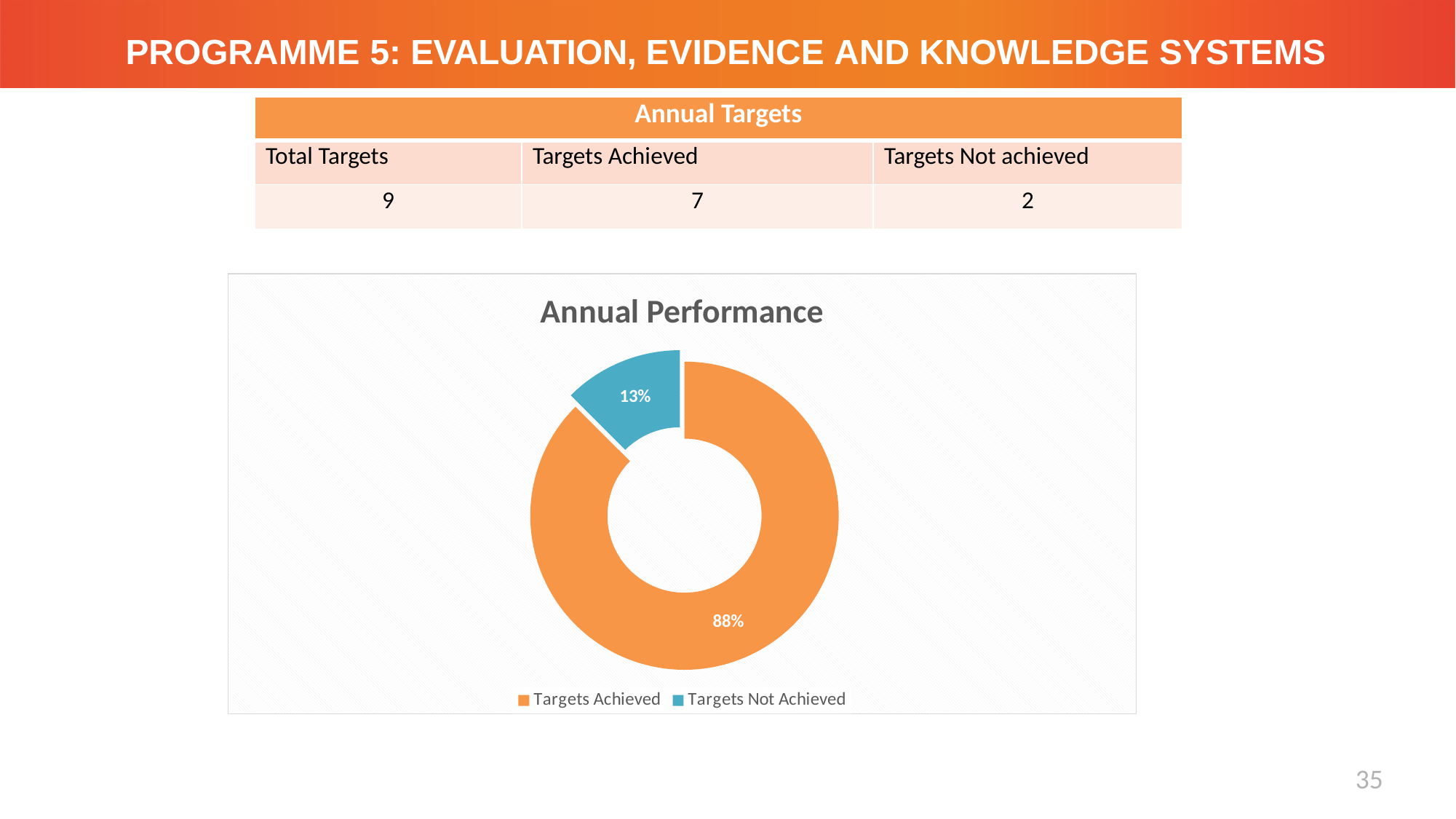
What is the difference in percentage points between Targets Achieved and Targets Not Achieved in the chart? 75 What colour represents Targets Not Achieved in the chart? Blue How many categories does the chart legend list? 2 Which category has the largest share of the chart? Targets Achieved What is the title of the chart? Annual Performance What percentage is shown for Targets Achieved in the chart? 88% Which is larger in the chart, Targets Achieved or Targets Not Achieved? Targets Achieved Is the share for Targets Achieved greater or less than 50%? greater Which category has the smallest share of the chart? Targets Not Achieved What percentage is shown for Targets Not Achieved in the chart? 13% What kind of chart is shown on the slide? Doughnut chart